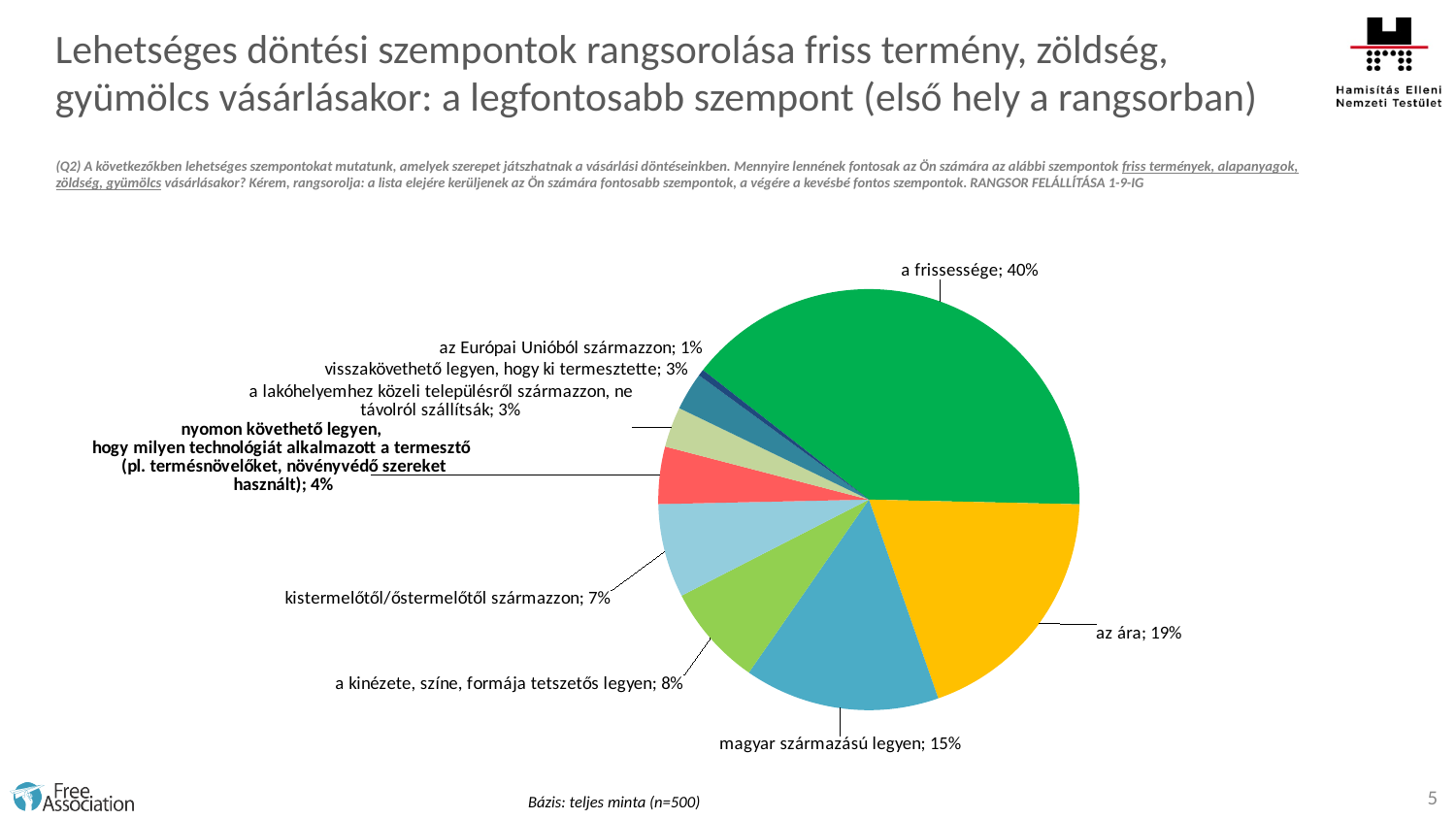
What share of the pie is labelled "a frissessége"? 40% Which category has the largest slice of the pie? a frissessége What is the value for "az ára"? 19% What is the sample size stated at the bottom of the slide? n=500 Which category has the smallest slice of the pie? az Európai Unióból származzon What kind of chart is shown on the slide? pie chart Which is larger: the share for "a kinézete, színe, formája tetszetős legyen" or for "kistermelőtől/őstermelőtől származzon"? a kinézete, színe, formája tetszetős legyen What is the value for "kistermelőtől/őstermelőtől származzon"? 7% What is the value for "magyar származású legyen"? 15% What is the difference between the shares for "a frissessége" and "az ára"? 21% What is the value for "az Európai Unióból származzon"? 1% How many slices does the pie chart have? 9